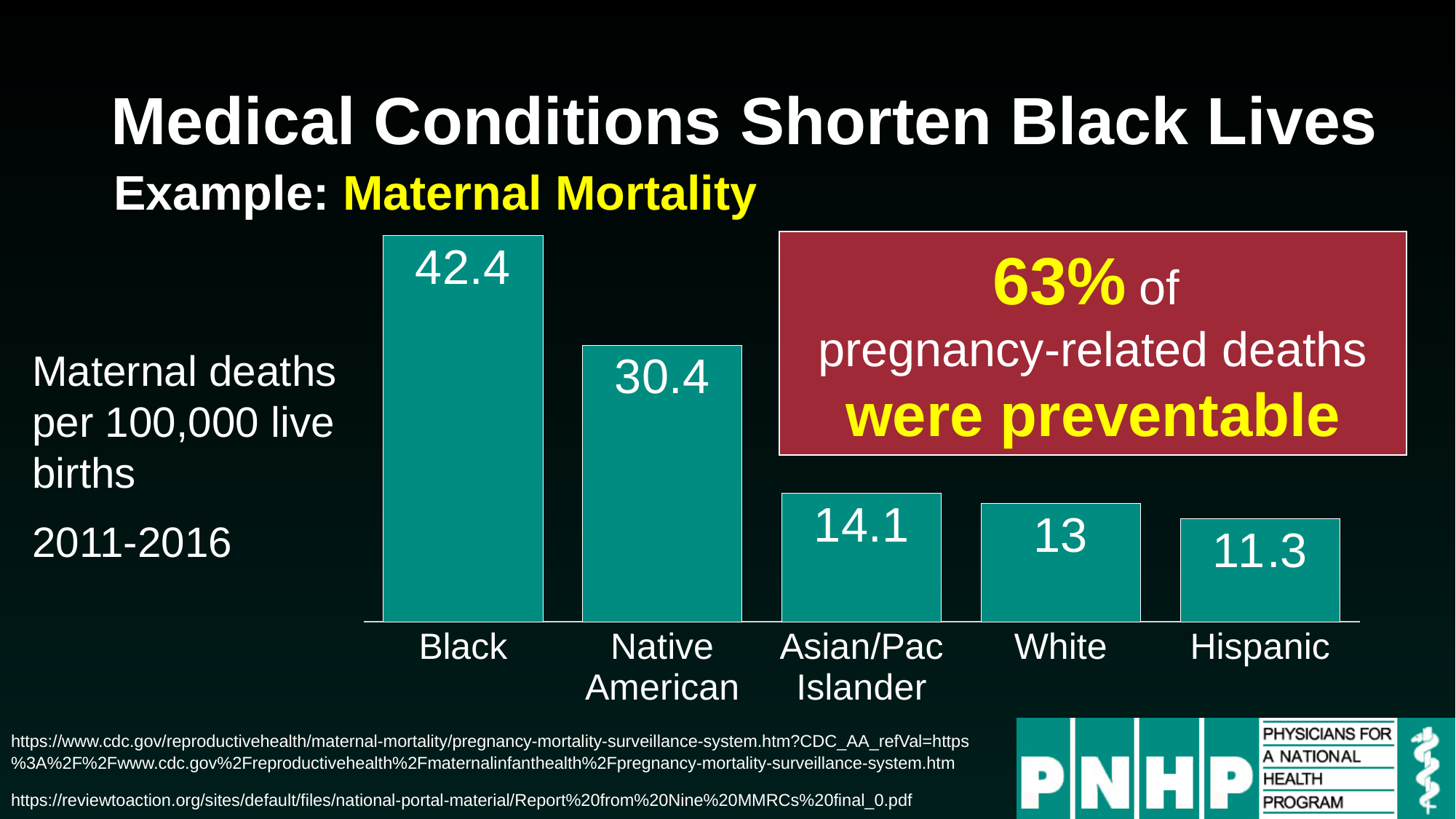
Which category has the lowest maternal mortality value? Hispanic What is the maternal mortality value for Asian/Pac Islander? 14.1 How many categories are shown in the chart? 5 What is the difference between the values for Native American and Hispanic? 19.1 What is the maternal mortality value for Hispanic? 11.3 What is the maternal mortality value for Native American? 30.4 Which is larger, the value for Black or the value for Native American? Black Which category has the highest maternal mortality value? Black What is the difference between the values for Black and White? 29.4 Do the values rise or fall from left to right across the categories? Fall What is the maternal mortality value for Black? 42.4 What kind of chart is shown on the slide? Bar chart